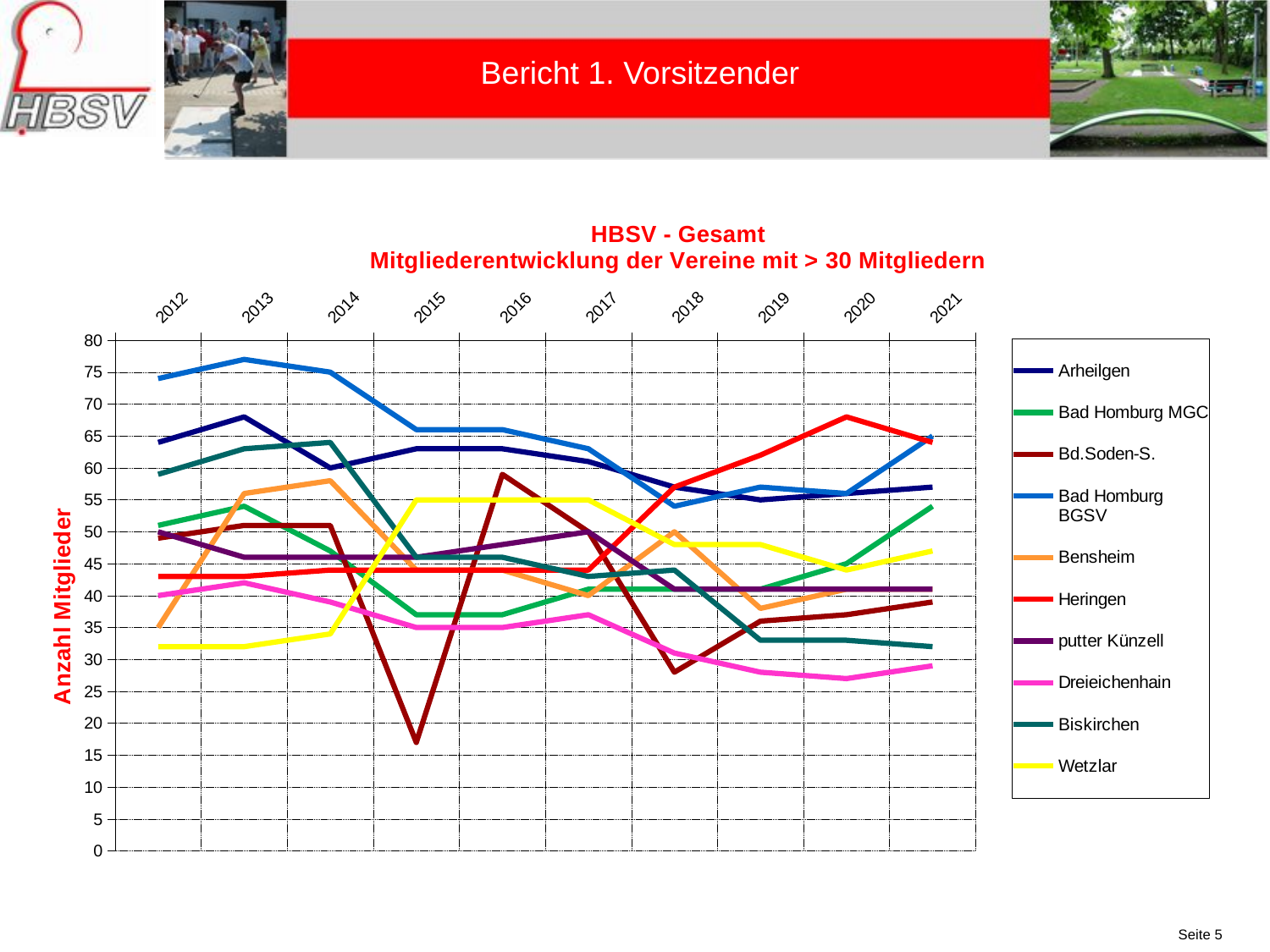
Which is larger in 2021, the value for Heringen or the value for Dreieichenhain? Heringen Which series has the highest value in 2020? Heringen Which series has the highest value in 2012? Bad Homburg BGSV What is the label of the y axis? Anzahl Mitglieder Is the value for Bd.Soden-S. in 2015 greater or less than 20? less Is the value for Wetzlar in 2012 greater or less than 40? less How many series does the legend list? 10 Do the values for Biskirchen rise or fall from 2012 to 2021? fall Is the value for Bad Homburg BGSV in 2013 greater or less than 70? greater What kind of chart is shown on the slide? line chart Which series has the lowest value in 2015? Bd.Soden-S. How many years are shown on the x axis? 10